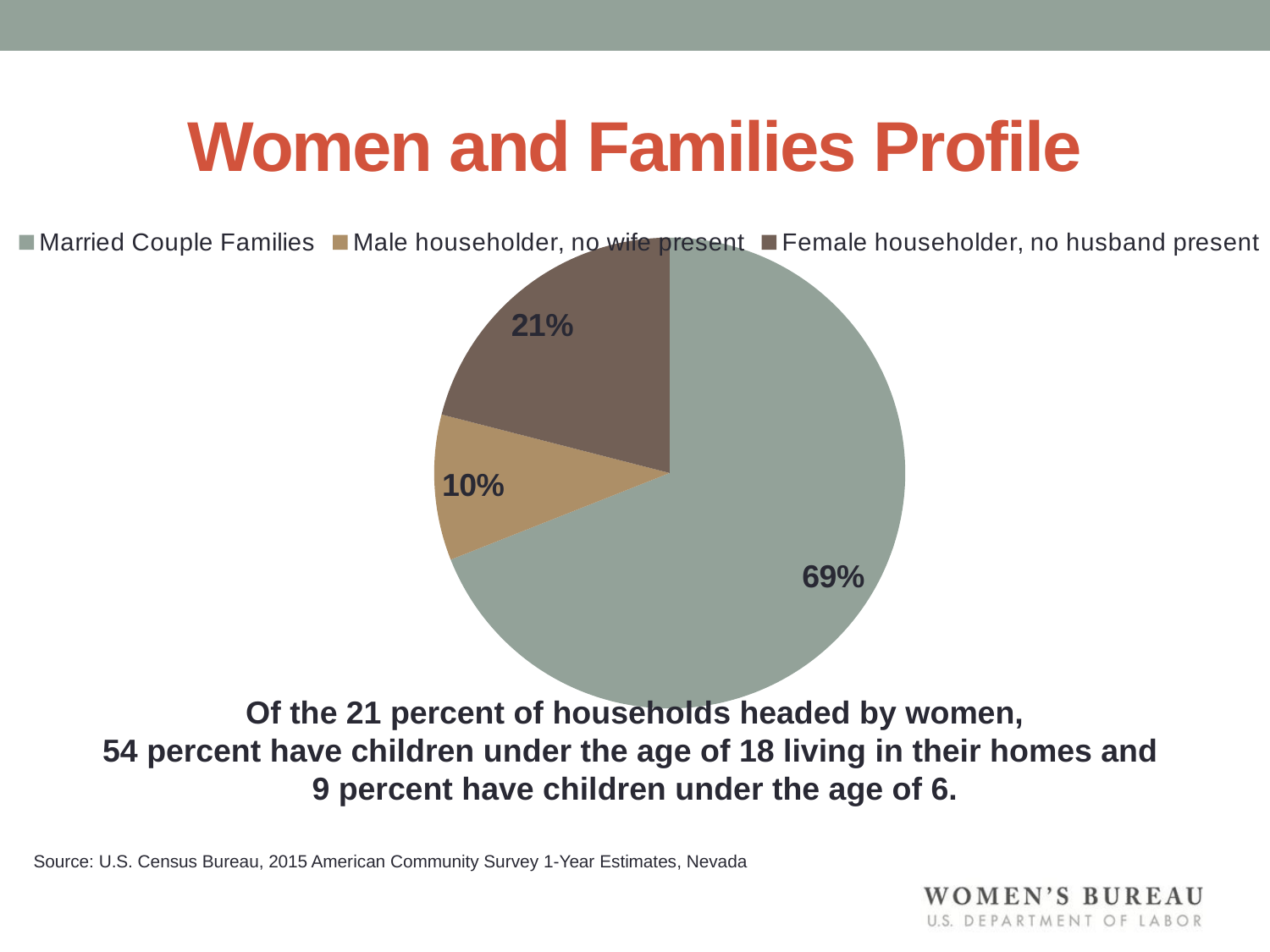
What is the difference in percentage points between Married Couple Families and Female householder, no husband present? 48 What share of the pie is Married Couple Families? 69% What share of the pie is Female householder, no husband present? 21% Which category has the largest slice of the pie? Married Couple Families What kind of chart is shown on the slide? Pie chart What share of the pie is Male householder, no wife present? 10% What is the difference in percentage points between Female householder, no husband present and Male householder, no wife present? 11 Which category has the smallest slice of the pie? Male householder, no wife present How many entries does the legend list? 3 Which is larger: the share for Female householder, no husband present or Male householder, no wife present? Female householder, no husband present What is the title of the slide containing the pie chart? Women and Families Profile How many slices does the pie chart have? 3